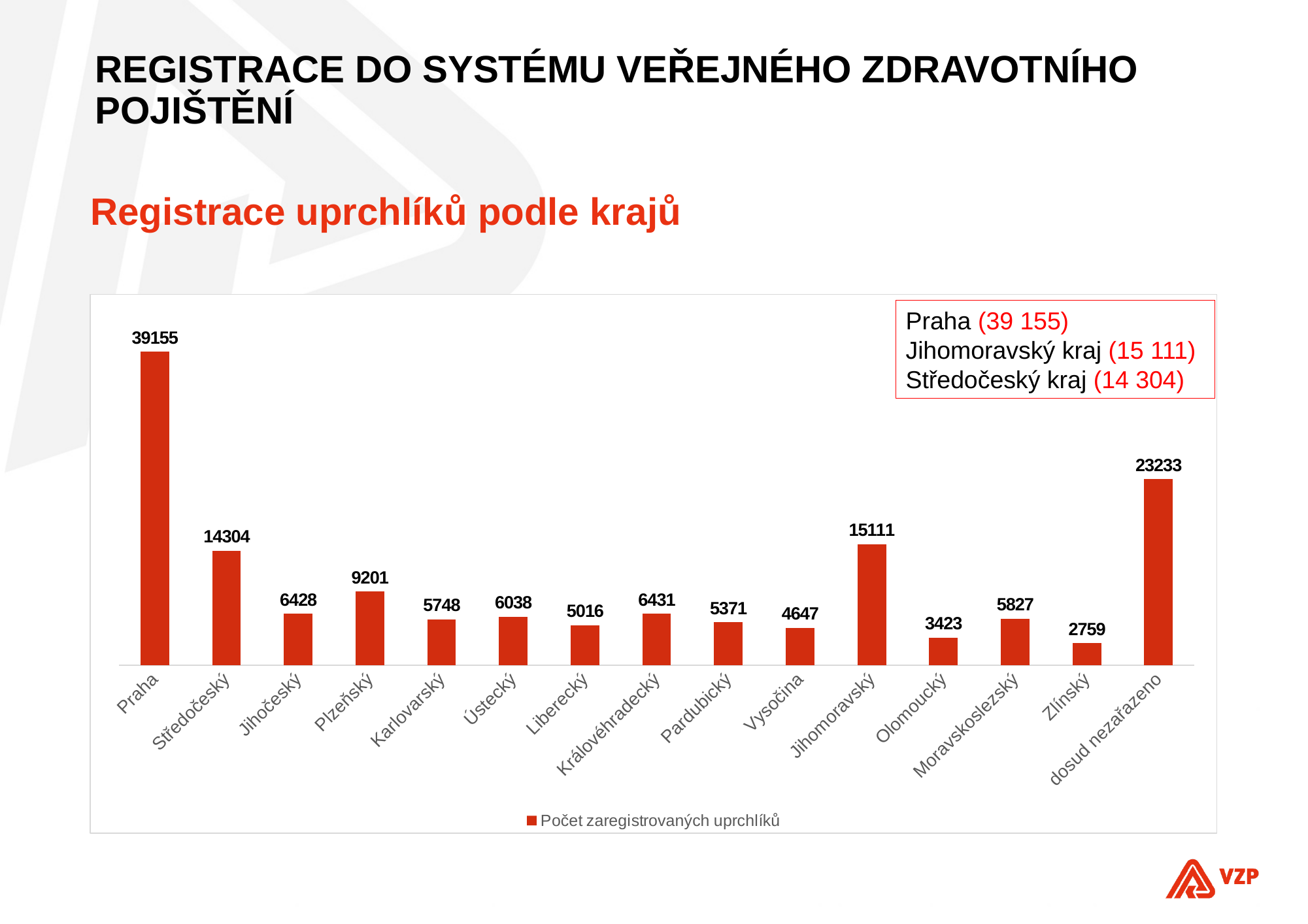
What is the value for Jihomoravský? 15111 What is the difference between the values for Praha and Jihomoravský? 24044 What is the value for dosud nezařazeno? 23233 Which category has the lowest value? Zlínský What is the value for Praha? 39155 What kind of chart is shown on the slide? bar chart How many series does the legend list? 1 What is the value for Zlínský? 2759 How many categories are shown on the x axis? 15 Which category has the highest value? Praha Which is larger, the value for Plzeňský or the value for Jihočeský? Plzeňský What is the difference between the values for Středočeský and Olomoucký? 10881